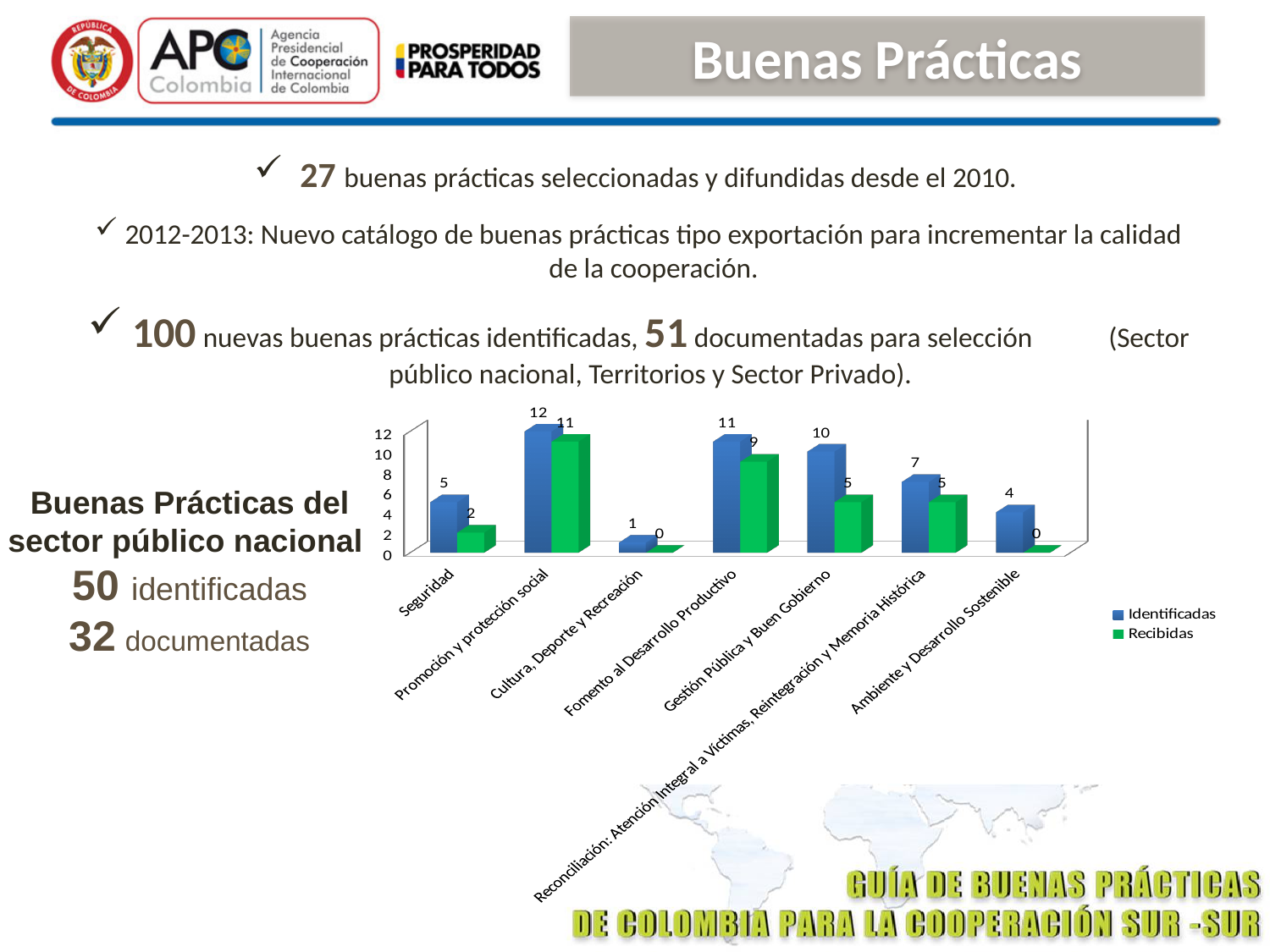
Which series is shown in green in the chart? Recibidas Which category has the lowest Identificadas value? Cultura, Deporte y Recreación How many series does the chart legend list? 2 What is the Recibidas value for Promoción y protección social? 11 Which category has the highest Identificadas value? Promoción y protección social What kind of chart is shown on the slide? Bar chart What is the Identificadas value for Gestión Pública y Buen Gobierno? 10 What is the Recibidas value for Ambiente y Desarrollo Sostenible? 0 How many categories are shown on the x axis of the chart? 7 Which is larger, the Identificadas value for Fomento al Desarrollo Productivo or the Identificadas value for Ambiente y Desarrollo Sostenible? Fomento al Desarrollo Productivo What is the difference between the Identificadas and Recibidas values for Gestión Pública y Buen Gobierno? 5 What is the Identificadas value for Seguridad? 5